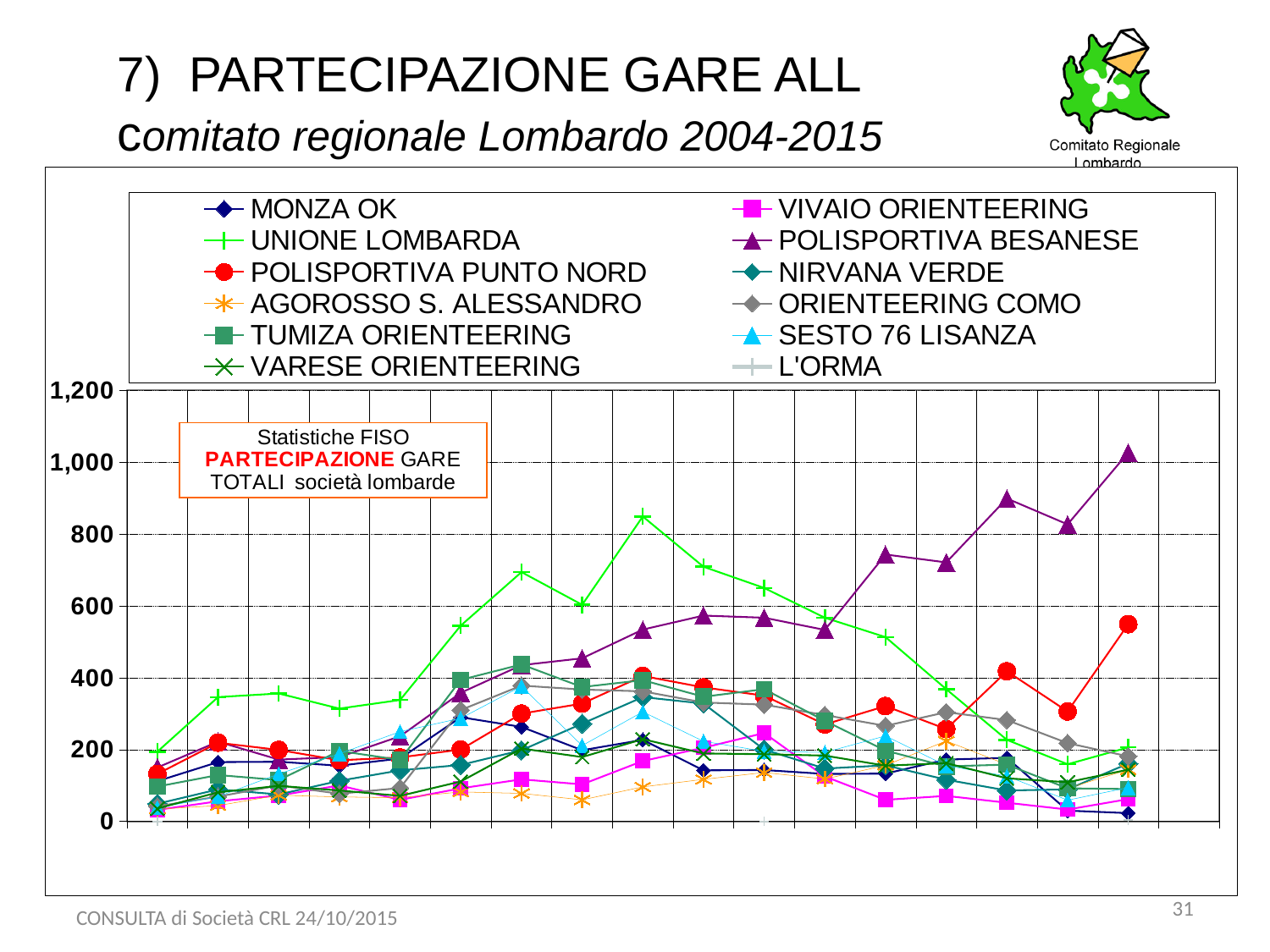
Is the highest value for UNIONE LOMBARDA greater or less than 800? greater At the last point on the x axis, which is larger: POLISPORTIVA BESANESE or POLISPORTIVA PUNTO NORD? POLISPORTIVA BESANESE Is the highest value for POLISPORTIVA BESANESE greater or less than 1,000? greater What marker colour and shape does the legend use for POLISPORTIVA PUNTO NORD? red circle How many series does the chart's legend list? 12 Is the highest value for VIVAIO ORIENTEERING greater or less than 400? less Which series reaches the highest value anywhere on the chart? POLISPORTIVA BESANESE What kind of chart is shown on the slide? line chart Does the POLISPORTIVA BESANESE series generally rise or fall along the x axis? rise What is the highest tick value shown on the y axis? 1,200 Which series has the higher peak value: UNIONE LOMBARDA or POLISPORTIVA BESANESE? POLISPORTIVA BESANESE